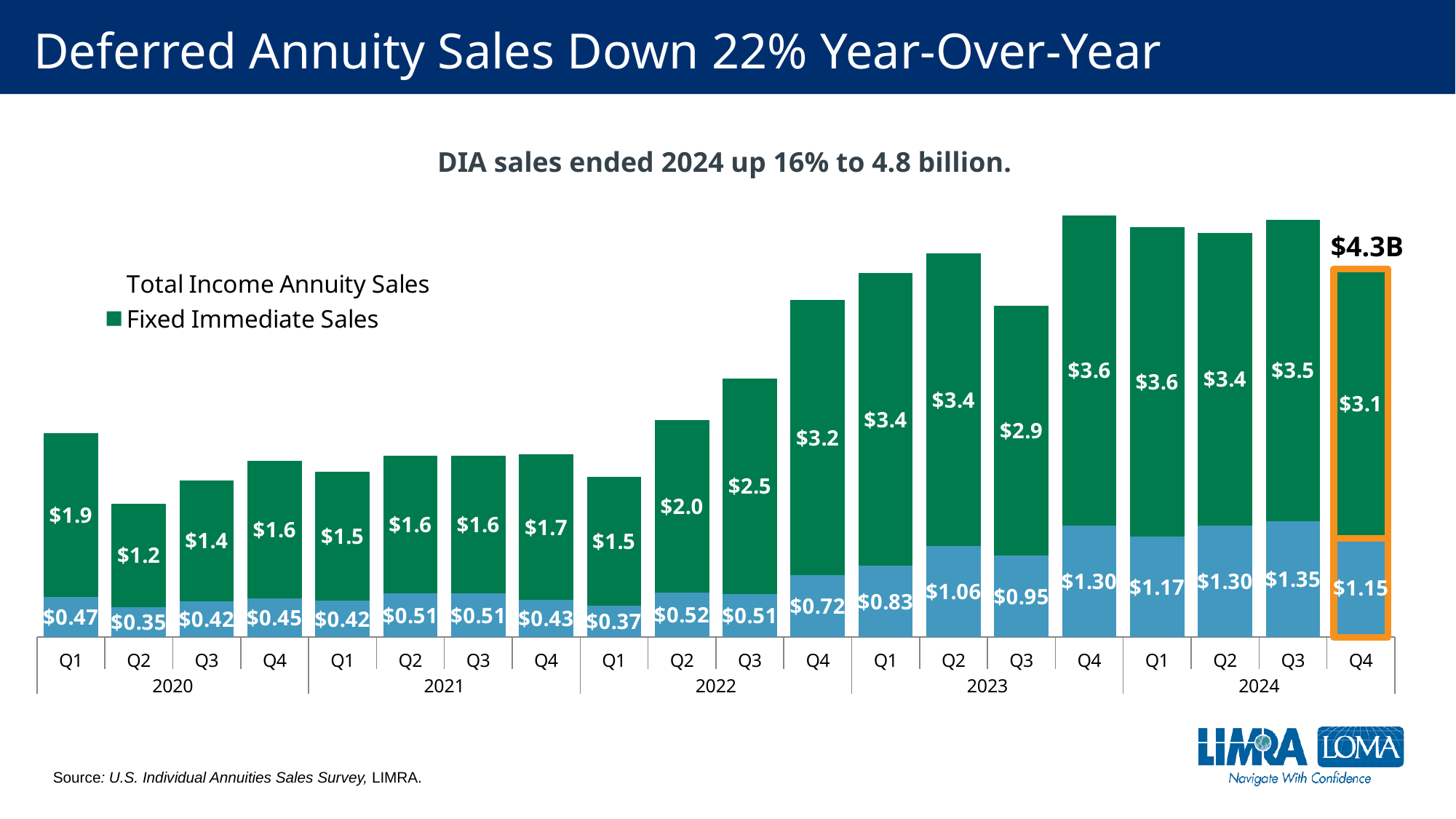
What is the difference between the blue (lower) segment values for Q3 2024 and Q4 2024? $0.20 Which quarter has the lowest value for the blue (lower) segment? Q2 2020 What is the value of the blue (lower) segment for Q3 2024? $1.35 What kind of chart is shown on the slide? Stacked bar chart What is the difference between the Fixed Immediate Sales values for Q1 2020 and Q2 2020? $0.7 Which has the larger Fixed Immediate Sales value, Q3 2023 or Q4 2023? Q4 2023 What is the Fixed Immediate Sales value for Q4 2024? $3.1 What is the value of the blue (lower) segment for Q1 2020? $0.47 What is the total printed for the Q4 2024 bar? $4.3B Do the Fixed Immediate Sales values rise or fall from Q1 2022 to Q4 2022? Rise How many quarters are shown on the x axis? 20 Which quarter has the lowest Fixed Immediate Sales value? Q2 2020